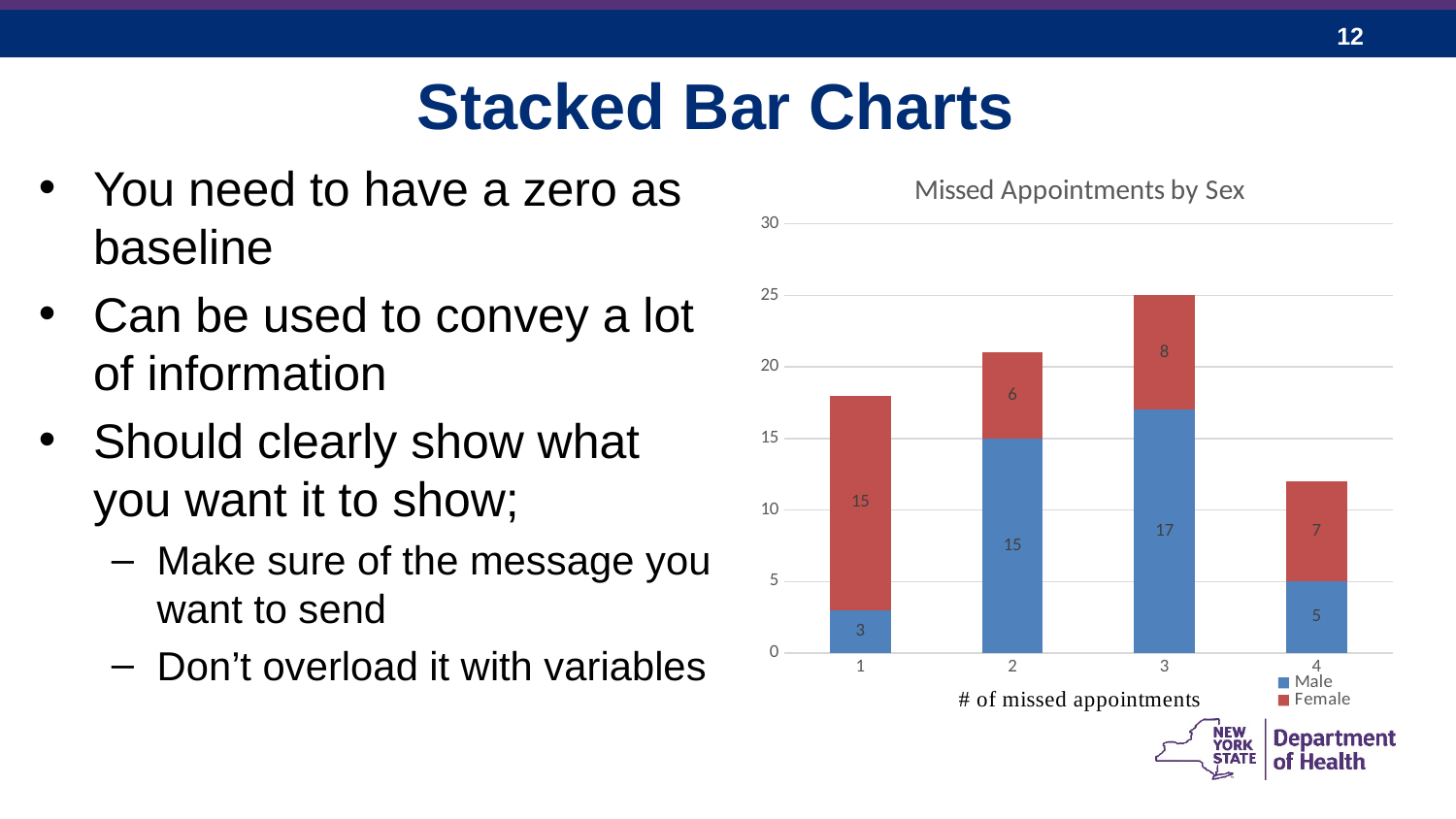
What is the Male value for category 3? 17 What is the title of the chart? Missed Appointments by Sex How many categories are shown on the x axis of the chart? 4 What is the difference between the Male and Female values for category 3? 9 What is the Female value for category 1? 15 What is the total of the stacked bar for category 2? 21 How many series does the chart legend list? 2 What kind of chart is shown on the slide? Stacked bar chart What is the Male value for category 4? 5 Which category has the highest Male value? 3 Which is larger for category 4, the Male value or the Female value? Female Which category has the lowest Male value? 1